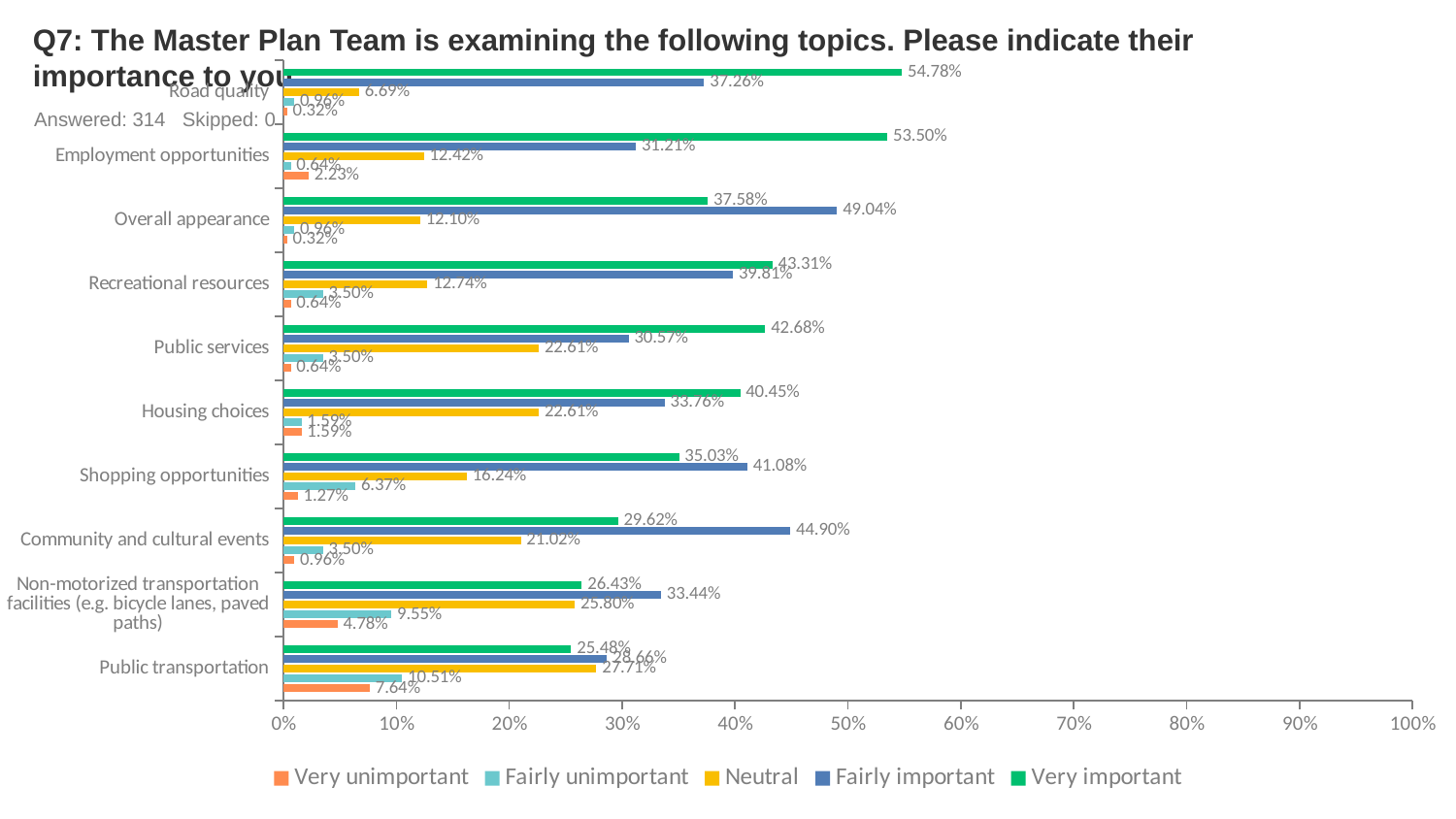
How many respondents answered this question according to the slide? 314 Which topic has the highest Very important percentage? Road quality What is the Neutral value for Non-motorized transportation facilities (e.g. bicycle lanes, paved paths)? 25.80% What is the Fairly important value for Overall appearance? 49.04% How many series does the legend list? 5 For Shopping opportunities, which is larger: the Fairly important value or the Very important value? Fairly important What kind of chart is shown on the slide? bar chart Which topic has the lowest Very important percentage? Public transportation What percentage rated Road quality as Very important? 54.78% How many topics are listed on the chart? 10 For Employment opportunities, what is the difference between the Very important and Fairly important percentages? 22.29% Is the Very unimportant value for Public transportation greater or less than 10%? less